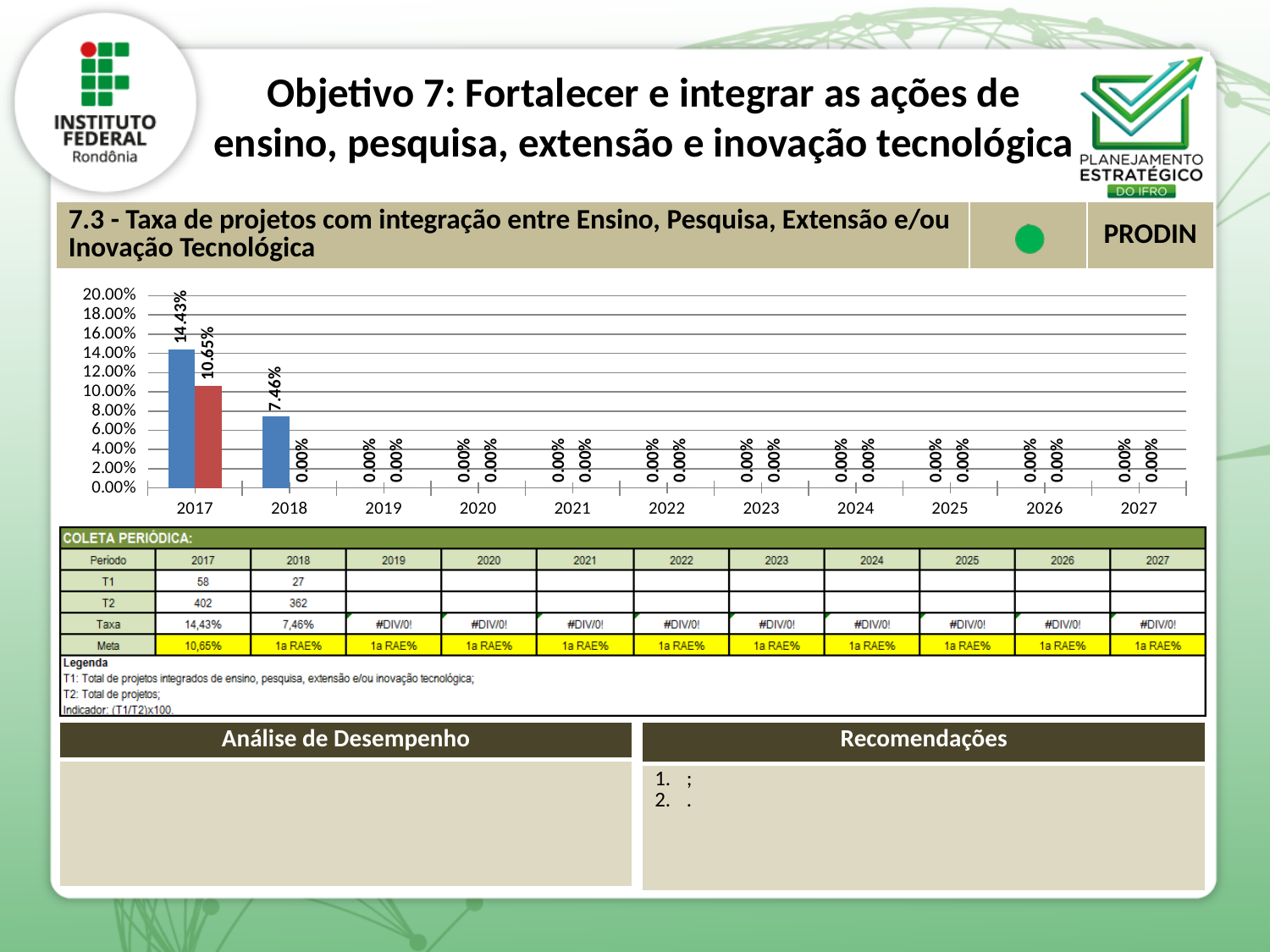
Which year has the highest blue bar? 2017 What kind of chart is shown on the slide? bar chart What is the difference between the blue bar for 2017 and the blue bar for 2018? 6.97% Is the value of the blue bar for 2017 greater or less than 12.00%? greater What is the difference between the blue bar and the red bar for 2017? 3.78% What is the value of the blue bar for 2017? 14.43% For 2017, which is larger, the blue bar or the red bar? the blue bar Do the blue bars rise or fall from 2017 to 2018? fall What is the value of the red bar for 2017? 10.65% What is the value of the red bar for 2018? 0.00% What is the value of the blue bar for 2018? 7.46% How many years are shown on the x axis of the chart? 11